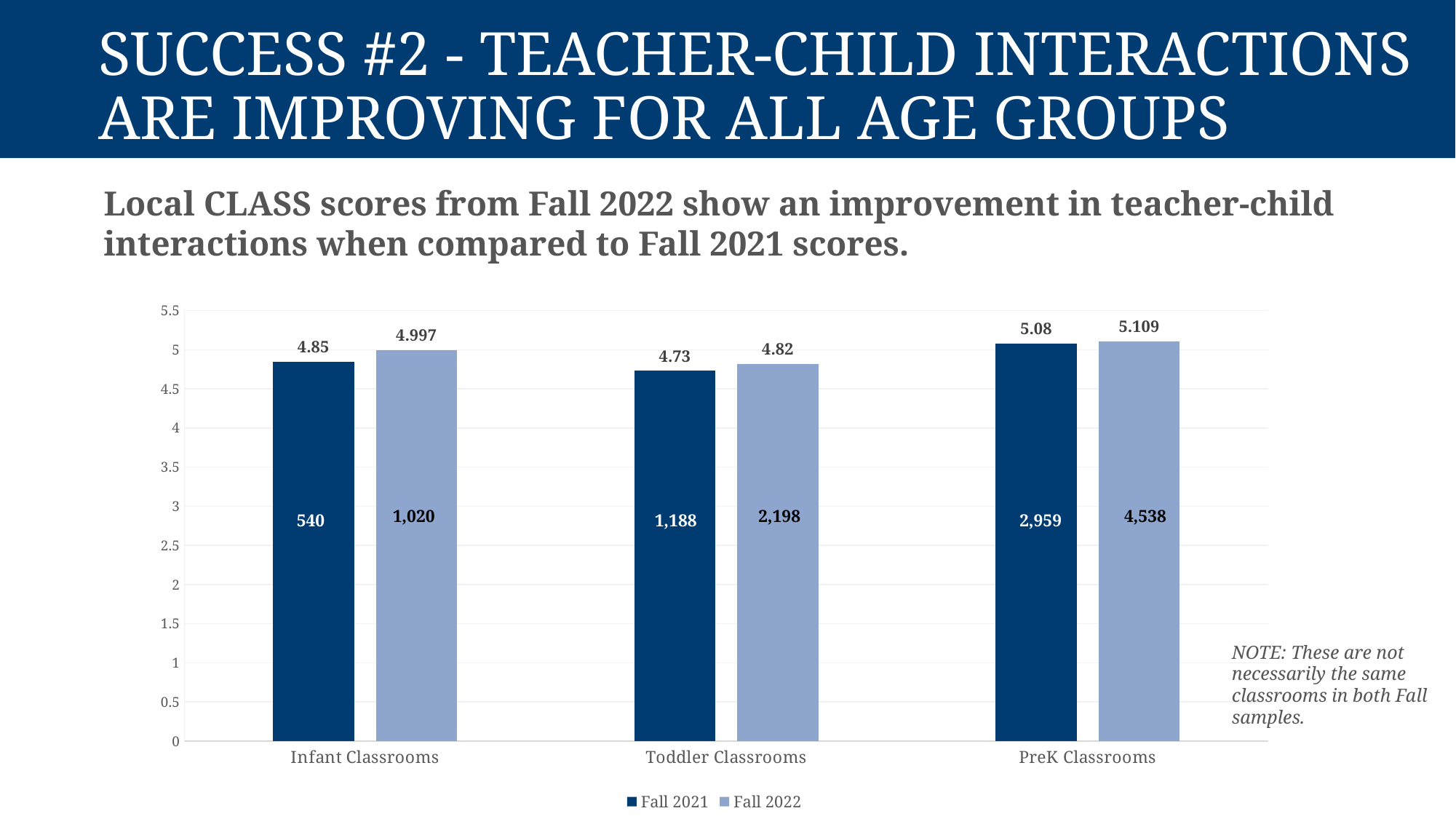
How many age group categories are shown on the x axis? 3 What kind of chart is shown on the slide? Bar chart What is the Fall 2021 CLASS score for Infant Classrooms? 4.85 What is the difference between the Fall 2022 and Fall 2021 scores for Toddler Classrooms? 0.09 Which age group has the highest Fall 2022 CLASS score? PreK Classrooms Is the Fall 2021 score for PreK Classrooms greater or less than 5? greater What is the Fall 2022 CLASS score for PreK Classrooms? 5.109 What number is printed inside the Fall 2022 bar for Infant Classrooms? 1,020 Which is larger for Infant Classrooms, the Fall 2021 score or the Fall 2022 score? Fall 2022 What is the Fall 2022 CLASS score for Toddler Classrooms? 4.82 How many series does the legend list? 2 Which age group has the lowest Fall 2021 CLASS score? Toddler Classrooms